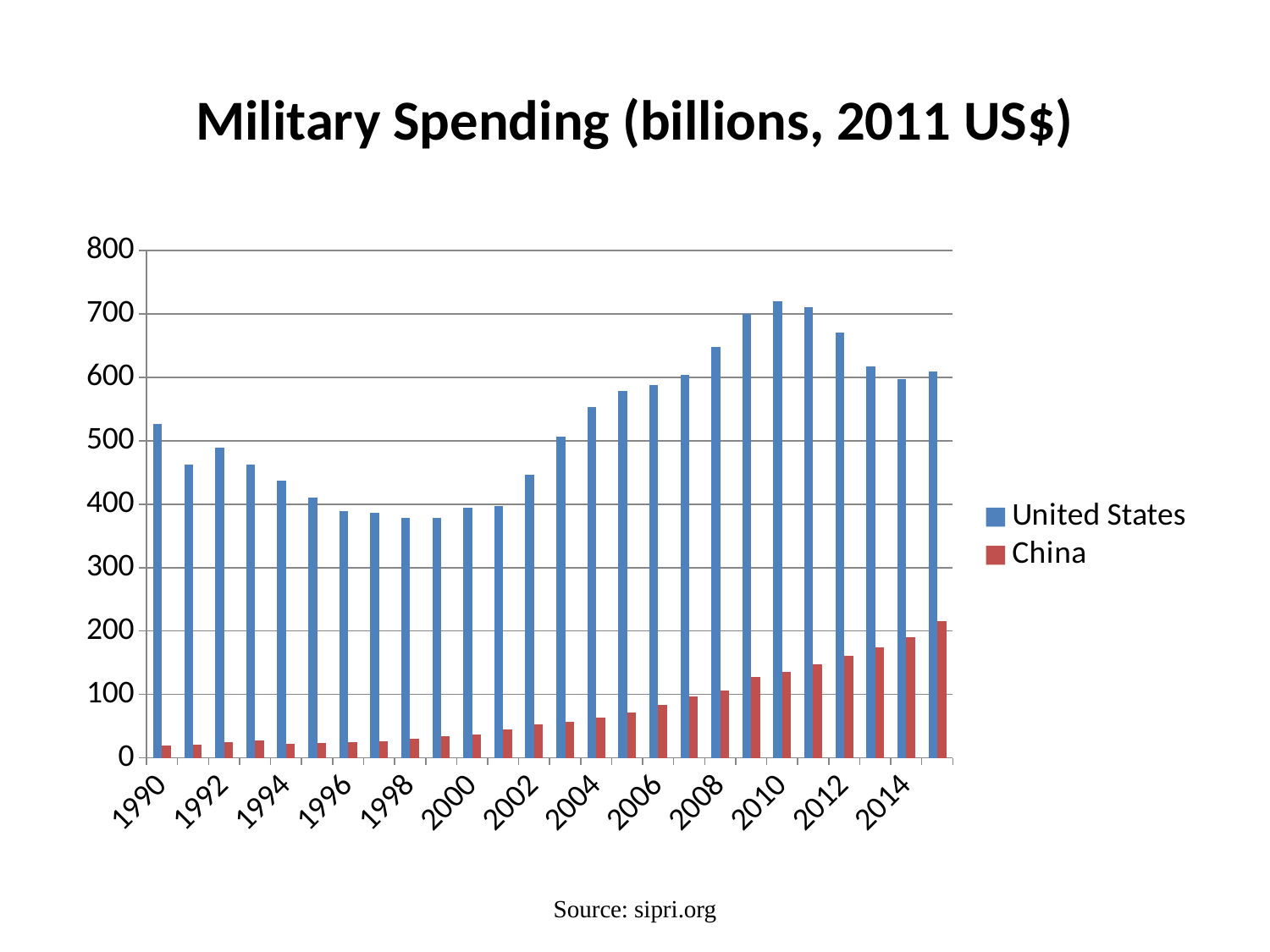
Do China's values rise or fall from 1990 to 2015? rise Is the China value for 2010 greater or less than 100? greater Is the China value for 2000 greater or less than 50? less In which year is China's military spending highest? 2015 What kind of chart is shown on the slide? bar chart Is the United States value for 1990 greater or less than 500? greater Which series is shown in red? China What is the title of the chart? Military Spending (billions, 2011 US$) In 2010, which is larger, the United States value or the China value? United States How many series does the legend list? 2